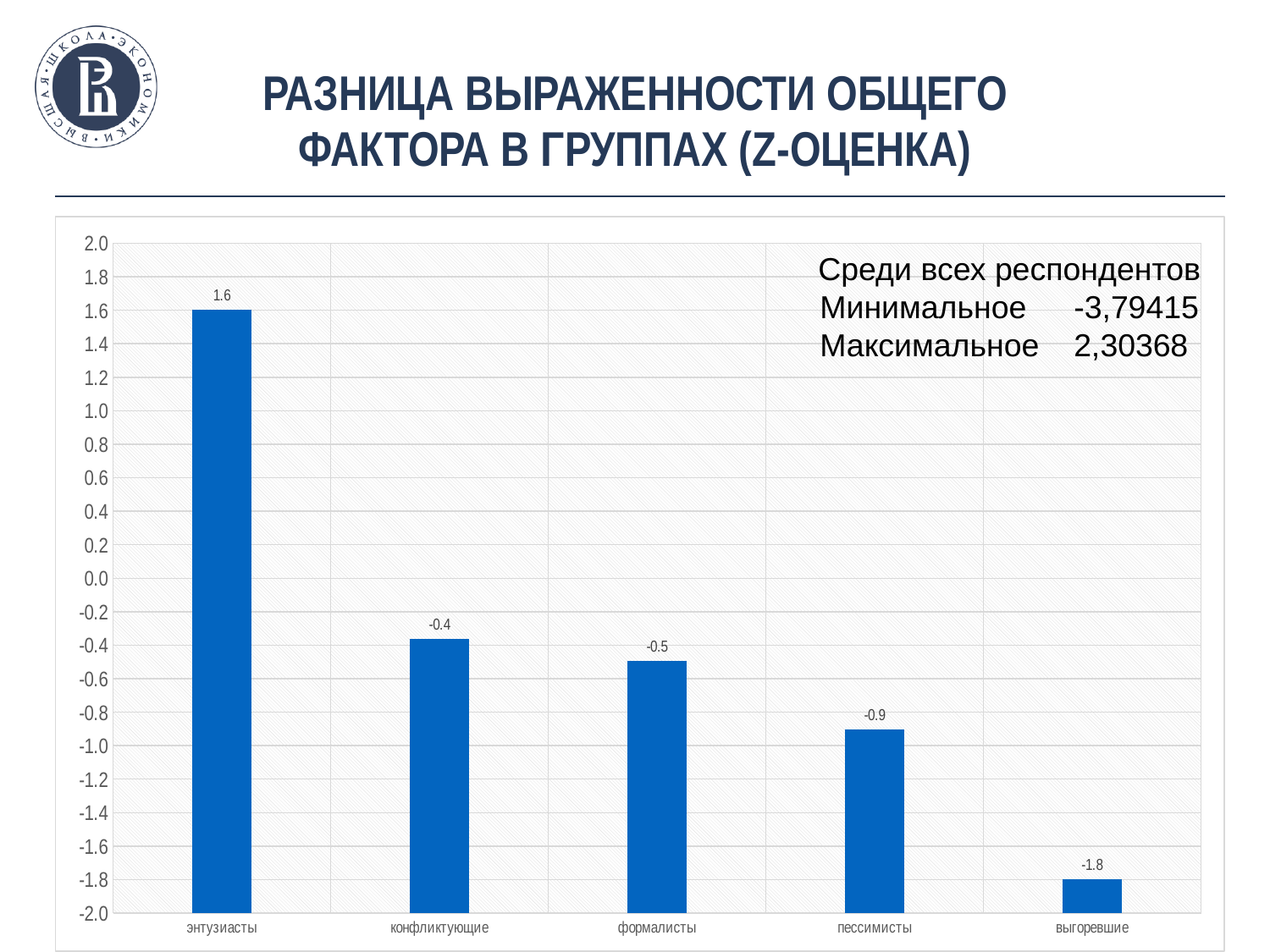
What is the value for пессимисты? -0.9 What is the value for энтузиасты? 1.6 What is the difference between the values for энтузиасты and выгоревшие? 3.4 What is the value for формалисты? -0.5 Which group has the highest value? энтузиасты Which group has the lowest value? выгоревшие Which is larger, the value for конфликтующие or the value for пессимисты? конфликтующие How many groups are shown on the x axis? 5 What is the value for выгоревшие? -1.8 Do the values rise or fall from left to right along the x axis? fall What is the value for конфликтующие? -0.4 What kind of chart is shown on the slide? bar chart